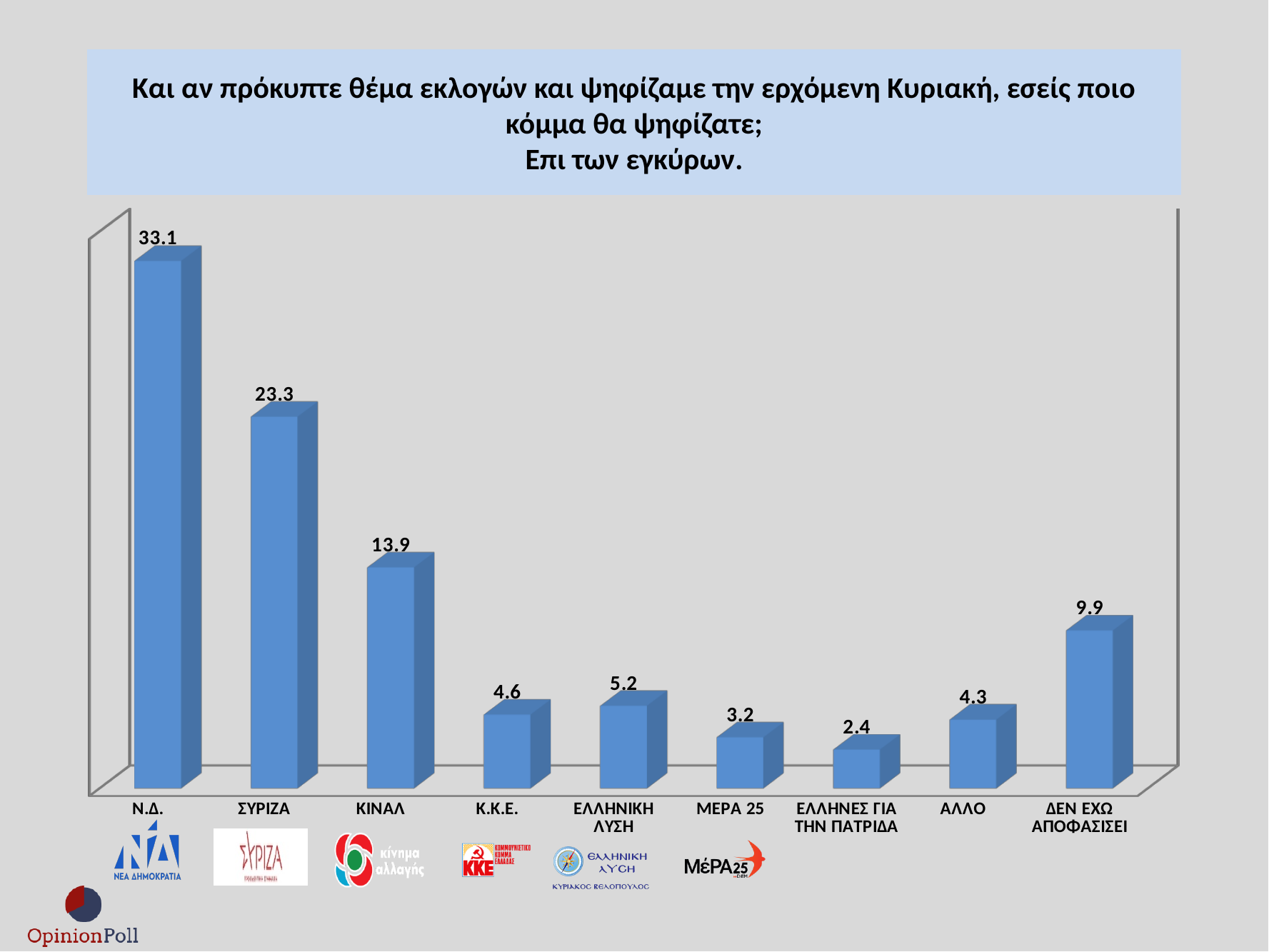
What value is shown for ΕΛΛΗΝΕΣ ΓΙΑ ΤΗΝ ΠΑΤΡΙΔΑ? 2.4 How many categories are shown on the chart? 9 Which has a larger value, ΑΛΛΟ or ΜΕΡΑ 25? ΑΛΛΟ What is the difference between the values for Ν.Δ. and ΣΥΡΙΖΑ? 9.8 What is the difference between the values for ΕΛΛΗΝΙΚΗ ΛΥΣΗ and Κ.Κ.Ε.? 0.6 Which category has the lowest value? ΕΛΛΗΝΕΣ ΓΙΑ ΤΗΝ ΠΑΤΡΙΔΑ Which category has the highest value? Ν.Δ. What kind of chart is shown on the slide? Bar chart What value is shown for ΣΥΡΙΖΑ? 23.3 What value is shown for ΔΕΝ ΕΧΩ ΑΠΟΦΑΣΙΣΕΙ? 9.9 What value is shown for ΚΙΝΑΛ? 13.9 What value is shown for Ν.Δ.? 33.1